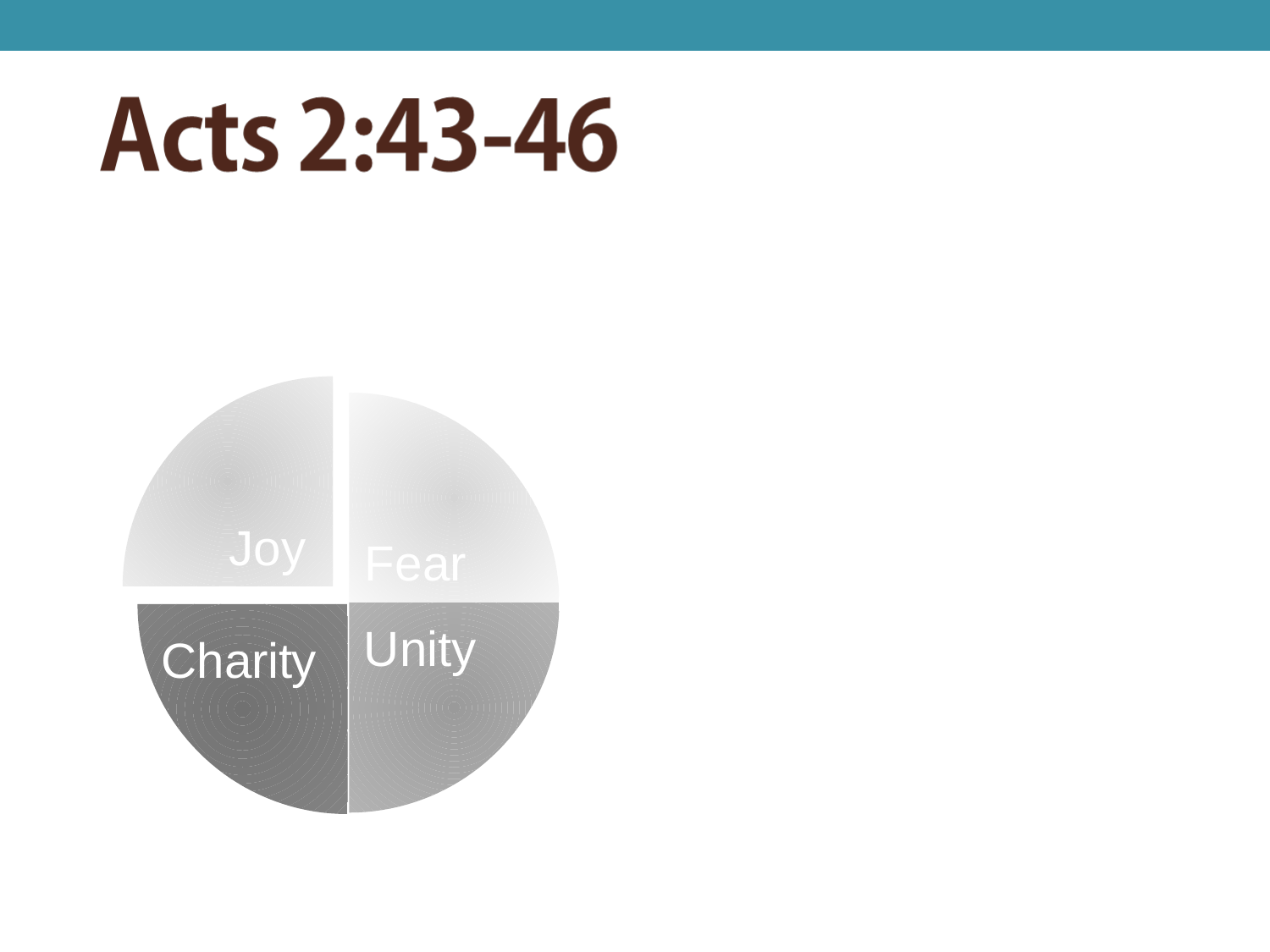
What kind of chart is shown on the slide? pie chart Which slice is located in the bottom-left quarter of the pie chart? Charity Which slice is located in the top-right quarter of the pie chart? Fear Which slice is located in the top-left quarter of the pie chart? Joy How many slices does the pie chart have? 4 What are the labels of the four slices in the pie chart? Joy, Fear, Charity, Unity What is the title of the slide containing the pie chart? Acts 2:43-46 Which slice is located in the bottom-right quarter of the pie chart? Unity